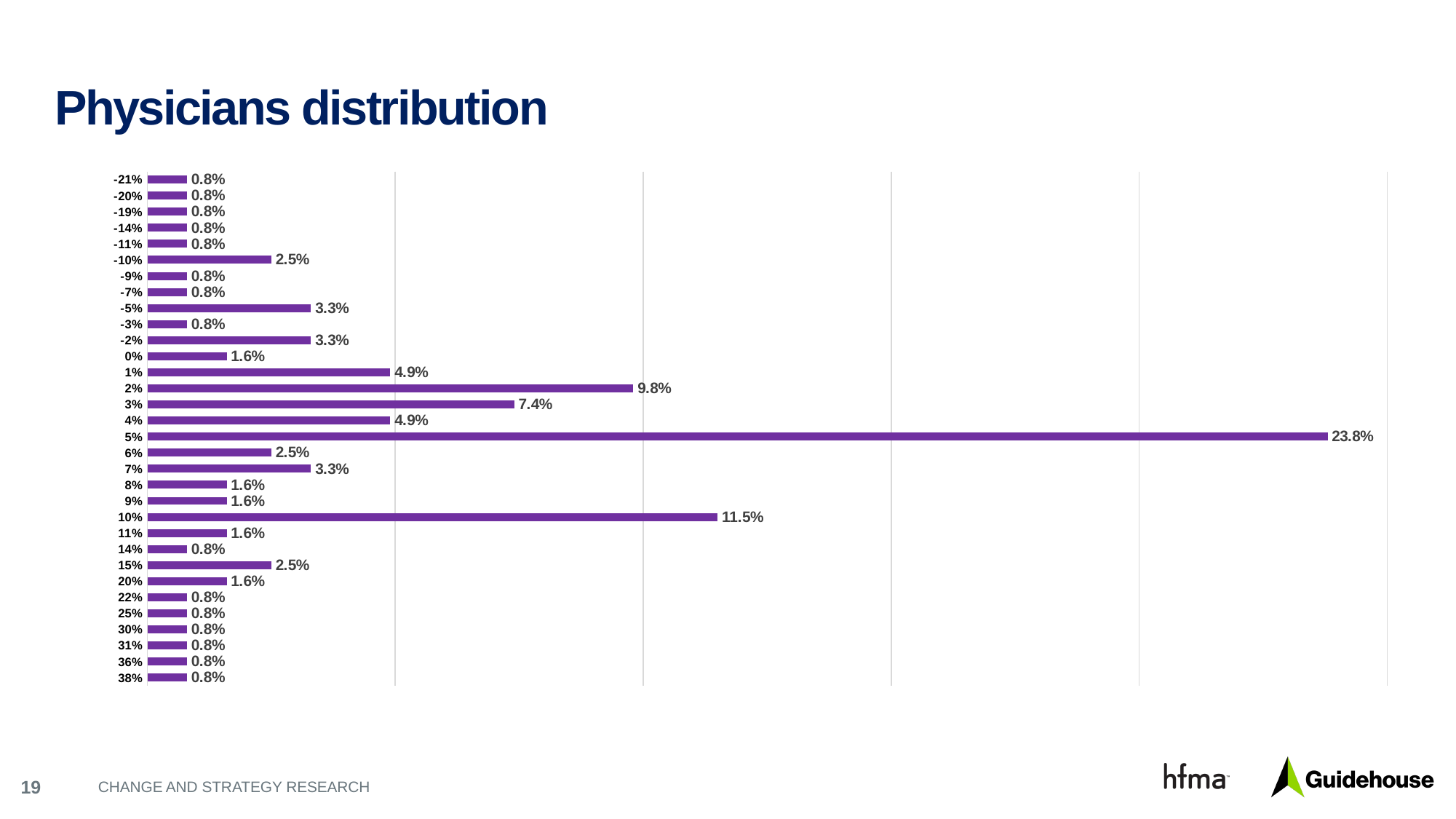
How many categories are shown in the chart? 32 What is the value for the 2% category? 9.8% Which has a larger value, the -5% category or the 0% category? -5% What is the difference between the values for the 2% and 3% categories? 2.4% What is the value for the 10% category? 11.5% What kind of chart is shown on the slide? Bar chart What is the value for the 3% category? 7.4% What is the difference between the values for the 5% and 10% categories? 12.3% What is the value for the 5% category? 23.8% Which has a larger value, the 1% category or the 7% category? 1% Which category has the highest value? 5% What is the value for the -10% category? 2.5%